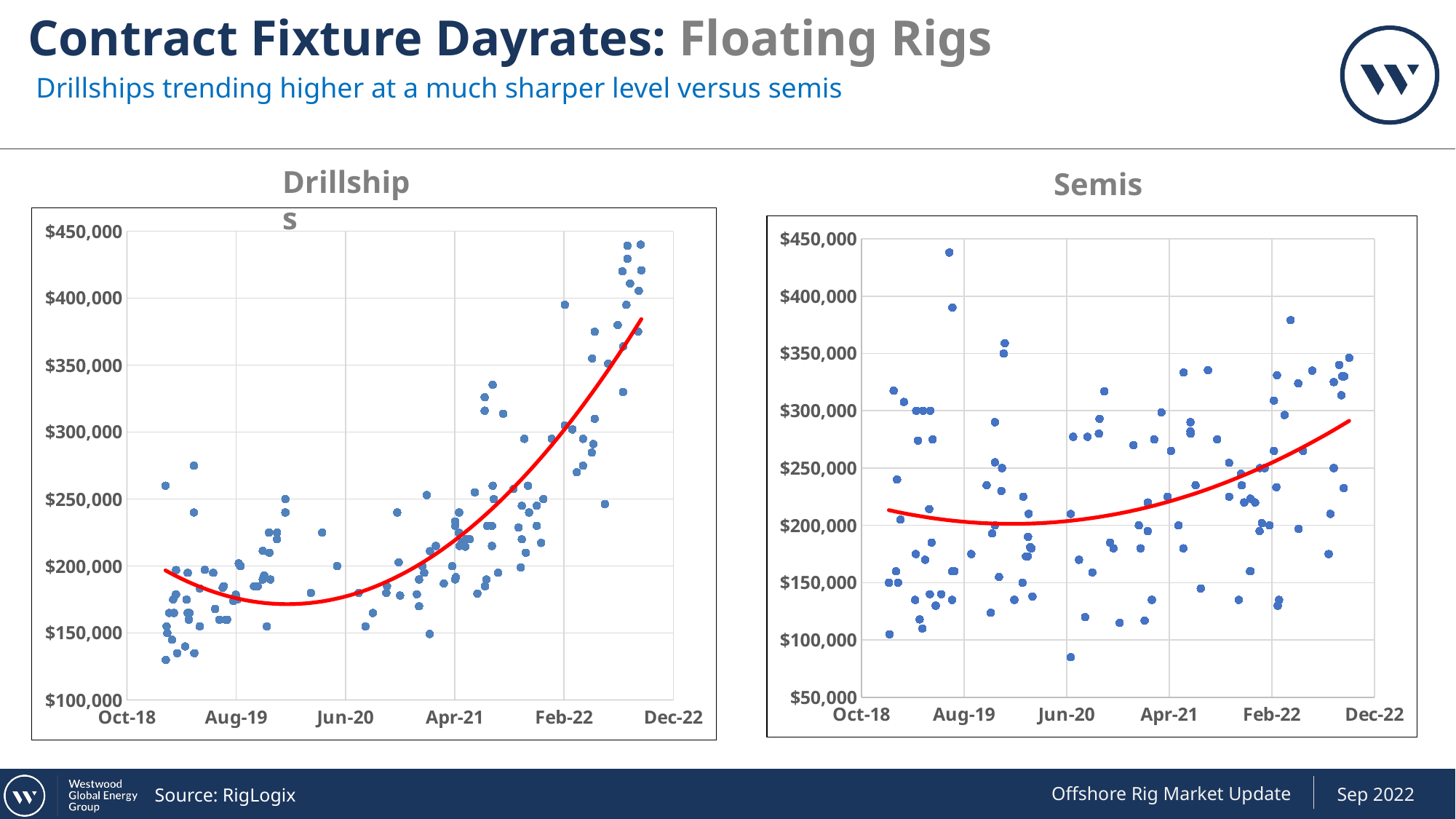
In the Drillships chart, does the red trend line rise or fall from Jun-20 to Dec-22? rises In the Drillships chart, are the highest plotted dayrates near Dec-22 greater or less than $400,000? greater Which chart's red trend line ends at a higher value at Dec-22, Drillships or Semis? Drillships In the Semis chart, is the value of the red trend line at Dec-22 greater or less than $250,000? greater What is the first x-axis label on the Drillships chart? Oct-18 What is the lowest value shown on the y-axis of the Drillships chart? $100,000 In the Semis chart, does the red trend line rise or fall from Jun-20 to Dec-22? rises What kind of chart is the Drillships chart? scatter chart What is the lowest value shown on the y-axis of the Semis chart? $50,000 In the Semis chart, is the lowest plotted dayrate (near Jun-20) greater or less than $100,000? less How many charts are shown on the slide? 2